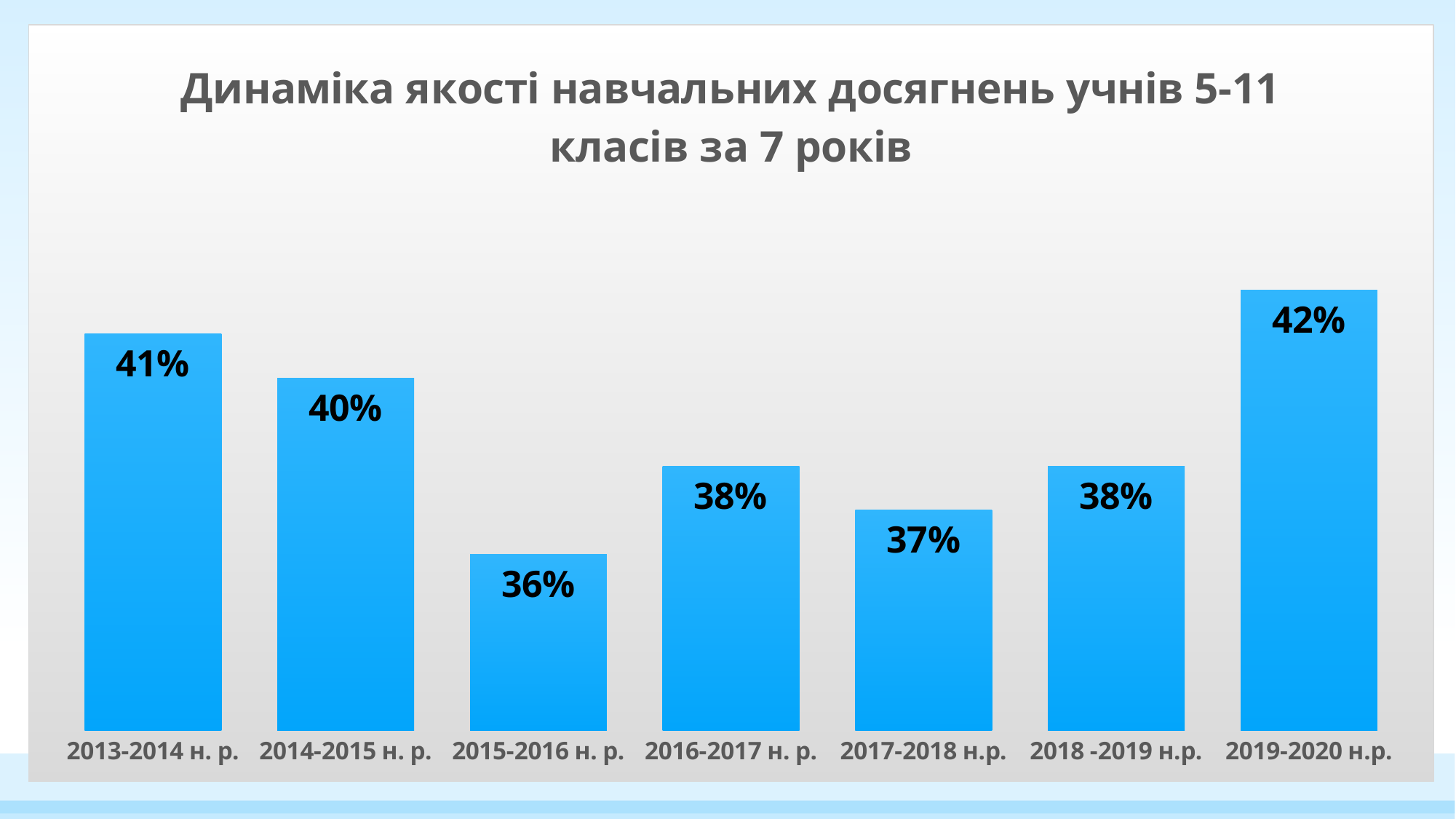
What is the difference between the values for 2019-2020 н.р. and 2015-2016 н. р.? 6% What is the value for 2019-2020 н.р.? 42% What is the title of the chart? Динаміка якості навчальних досягнень учнів 5-11 класів за 7 років What is the value for 2015-2016 н. р.? 36% How many school years are shown on the chart? 7 Which is larger, the value for 2016-2017 н. р. or the value for 2017-2018 н.р.? 2016-2017 н. р. What kind of chart is shown on the slide? Bar chart Which school year has the highest value? 2019-2020 н.р. What is the value for 2013-2014 н. р.? 41% Which school year has the lowest value? 2015-2016 н. р. What is the difference between the values for 2013-2014 н. р. and 2014-2015 н. р.? 1% What is the value for 2017-2018 н.р.? 37%